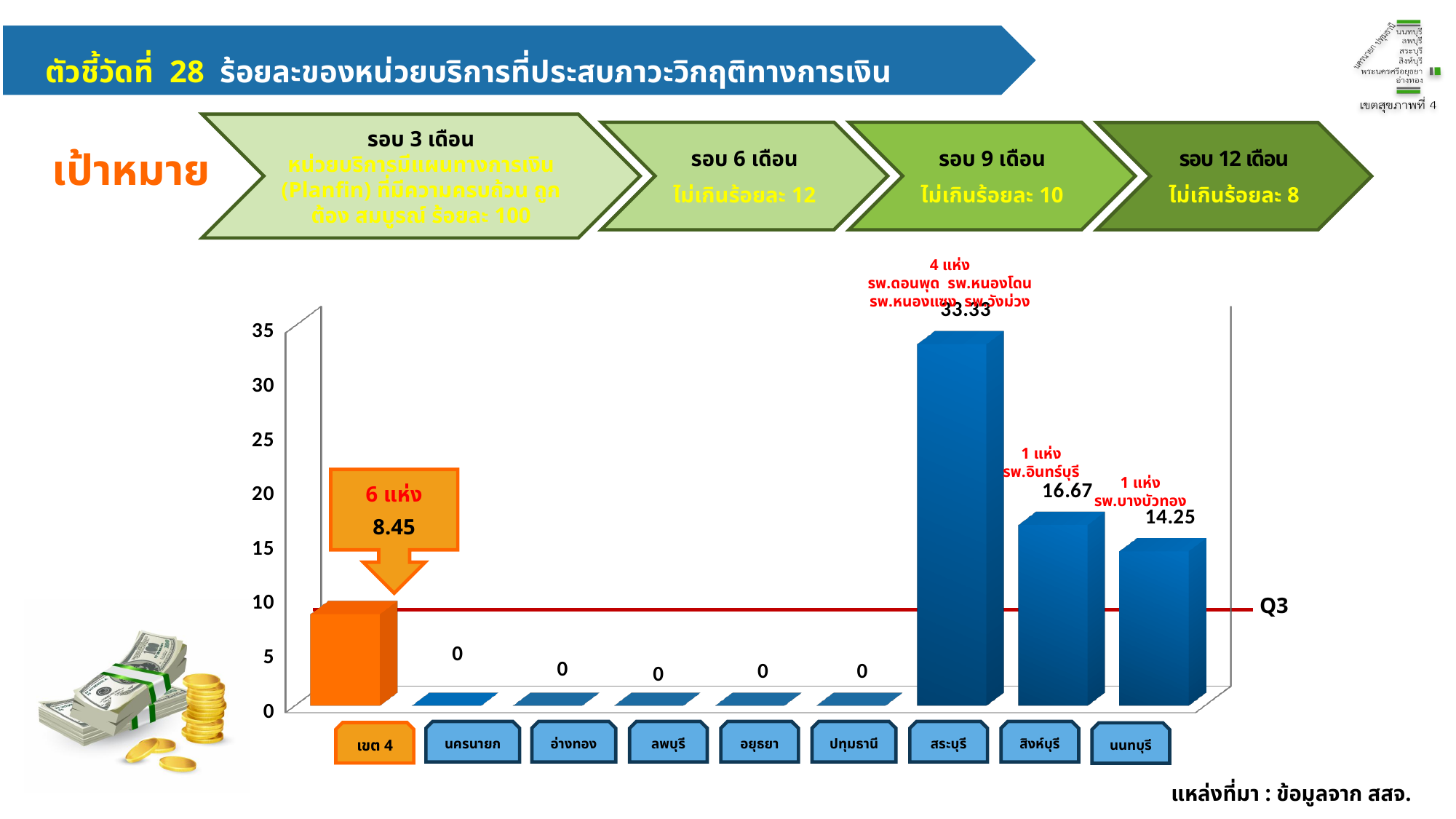
Is the value for สระบุรี greater or less than 30? greater Which category has the highest value? สระบุรี What is the difference between the values for สระบุรี and สิงห์บุรี? 16.66 What kind of chart is shown on the slide? bar chart How many provinces have a value of 0? 5 What is the value for สิงห์บุรี? 16.67 How many categories are shown on the x axis? 9 What is the value for นนทบุรี? 14.25 Which is larger, the value for สิงห์บุรี or the value for นนทบุรี? สิงห์บุรี What is the value for เขต 4? 8.45 What is the value for ลพบุรี? 0 What is the value for สระบุรี? 33.33